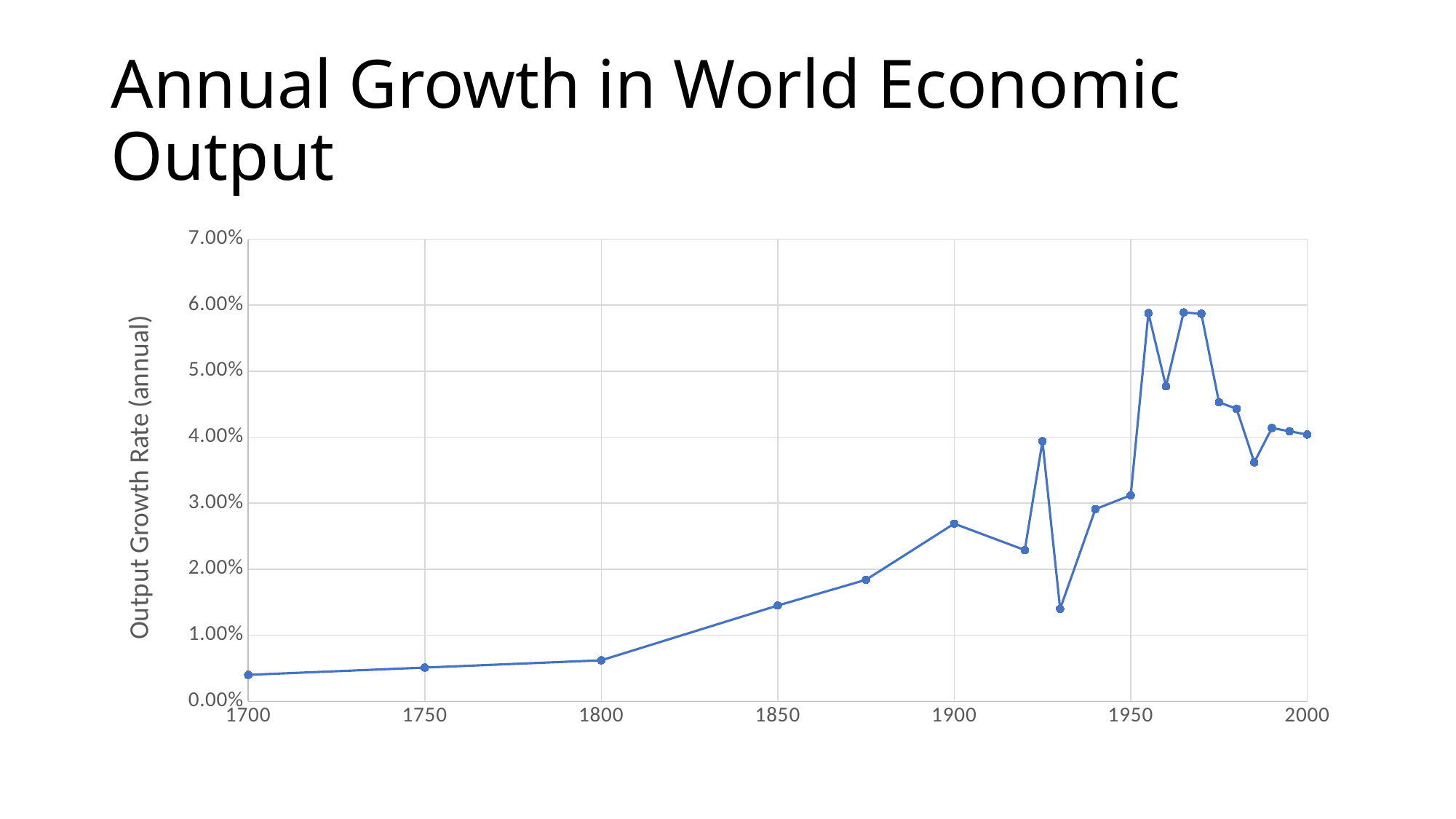
Does the output growth rate rise or fall between 1700 and 1900? rise What kind of chart is shown on the slide? line chart Which has the higher output growth rate, 1900 or 1930? 1900 Which year has the lowest output growth rate on the chart? 1700 What is the title of the chart on the slide? Annual Growth in World Economic Output Is the value for 1700 greater or less than 1.00%? less Is the value for 1930 greater or less than 2.00%? less What is the label on the vertical axis of the chart? Output Growth Rate (annual) Is the value for 1985 greater or less than 4.00%? less Which has the higher output growth rate, 1955 or 1960? 1955